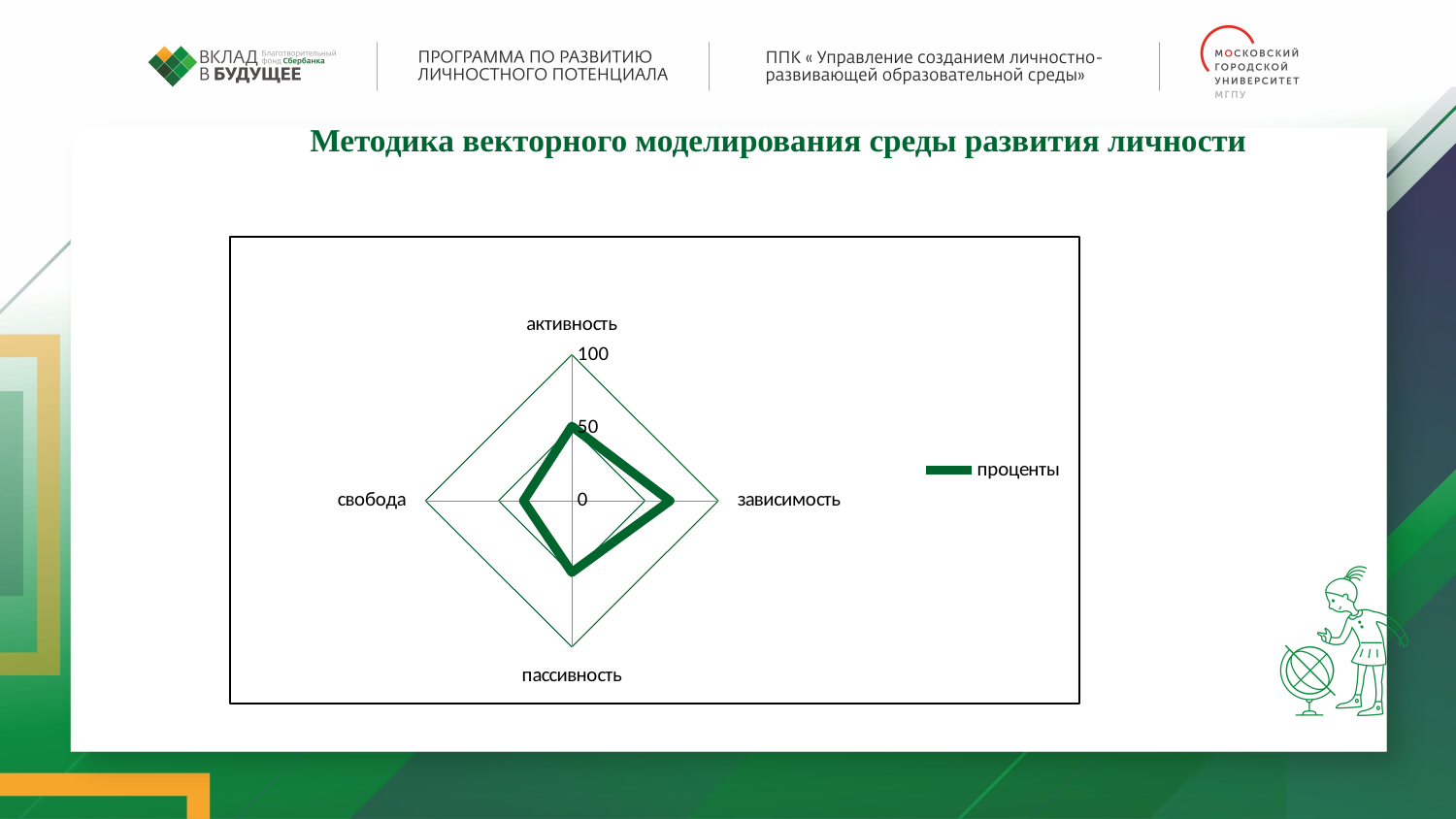
What is the title of the slide above the chart? Методика векторного моделирования среды развития личности Which category has the lowest value? свобода Which category has the highest value? зависимость Which is larger, the value for зависимость or the value for активность? зависимость What kind of chart is shown on the slide? radar chart Is the value for свобода greater or less than 50? less How many categories (axes) does the radar chart have? 4 Is the value for зависимость greater or less than 50? greater Is the value for зависимость greater or less than 100? less Which is larger, the value for зависимость or the value for свобода? зависимость What is the name of the series shown in the legend? проценты How many series does the legend list? 1